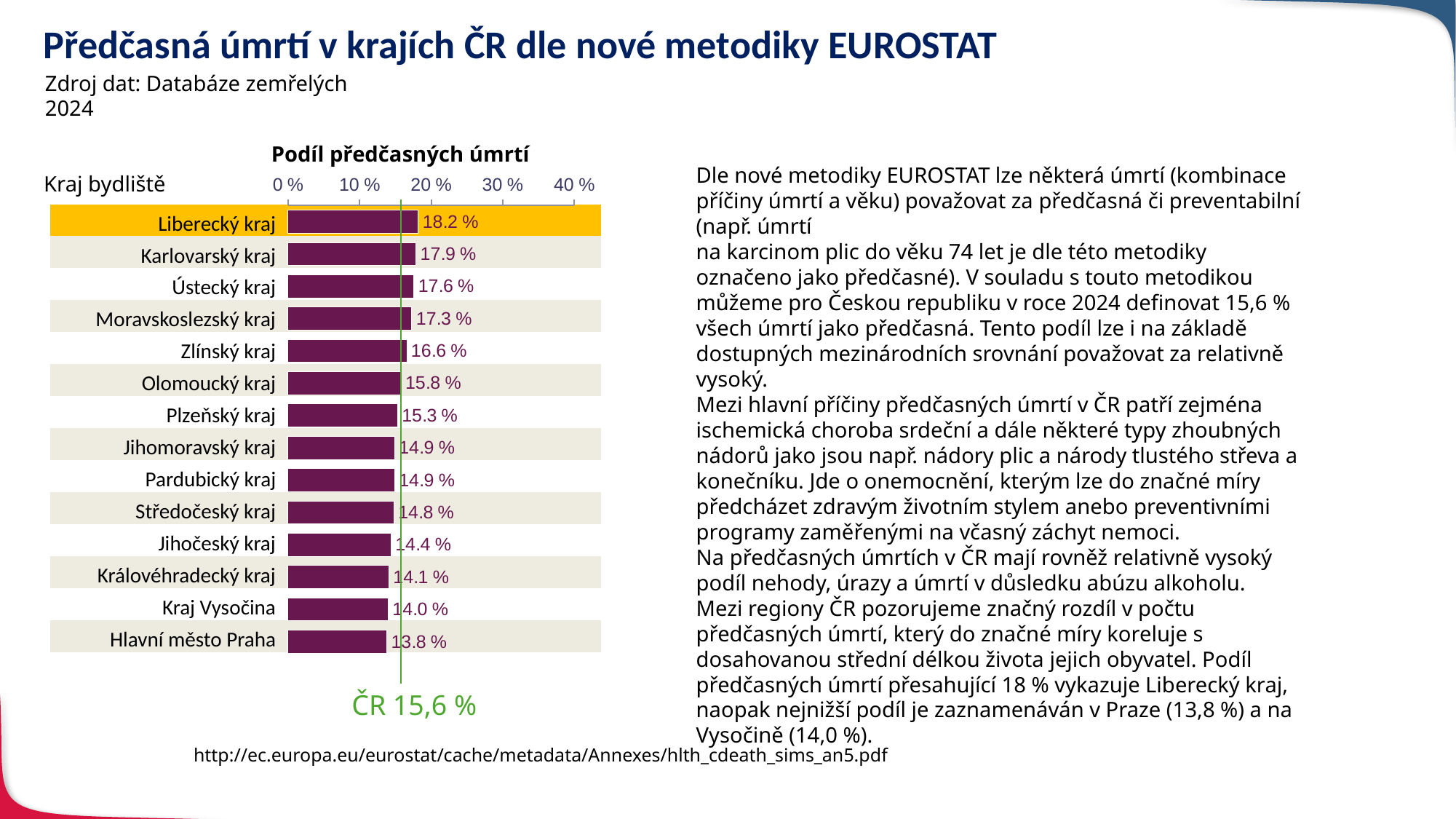
What is the difference between the values for Liberecký kraj and Hlavní město Praha? 4.4 % Which is larger, the value for Karlovarský kraj or the value for Ústecký kraj? Karlovarský kraj What is the value for Hlavní město Praha? 13.8 % Is the value for Olomoucký kraj greater or less than 10 %? greater How many regions are shown in the chart? 14 Which region has the highest share of premature deaths? Liberecký kraj What value does the green vertical reference line labelled ČR mark? 15,6 % What is the value for Liberecký kraj? 18.2 % What kind of chart is shown on the slide? bar chart Which region has the lowest share of premature deaths? Hlavní město Praha What is the title of the chart? Podíl předčasných úmrtí What is the value for Zlínský kraj? 16.6 %